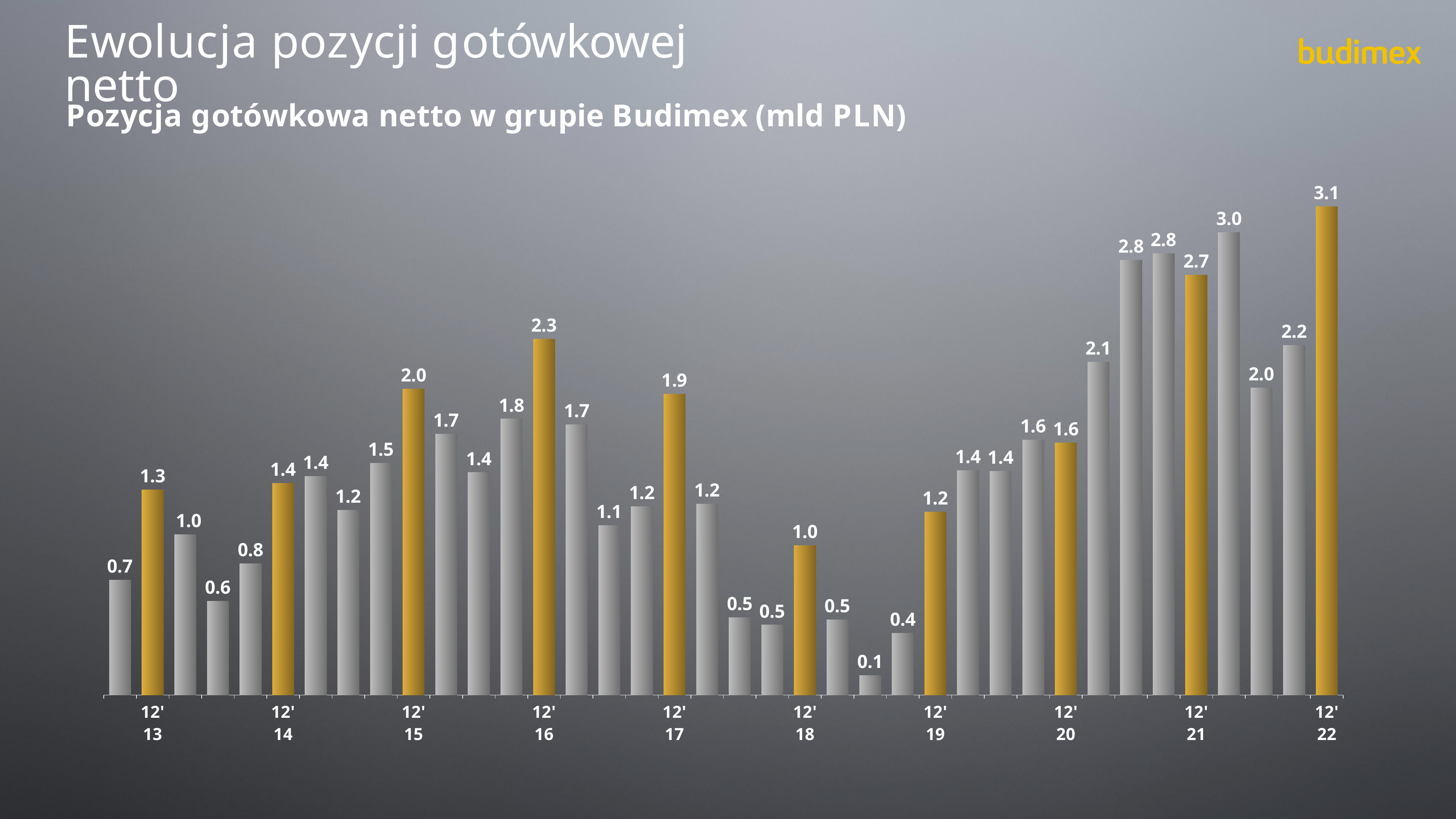
Which labelled year-end period has the highest value? 12'22 What kind of chart is shown on the slide? Bar chart What is the value for 12'21? 2.7 Which is larger, the value for 12'15 or the value for 12'19? 12'15 What is the difference between the values for 12'16 and 12'17? 0.4 Which labelled year-end period has the lowest value? 12'18 What is the difference between the values for 12'22 and 12'21? 0.4 What unit is stated in the chart subtitle? mld PLN What is the value for 12'18? 1.0 How many year-end periods are labelled on the x axis? 10 What is the net cash position shown for 12'22? 3.1 What value is labelled on the bar for 12'16? 2.3